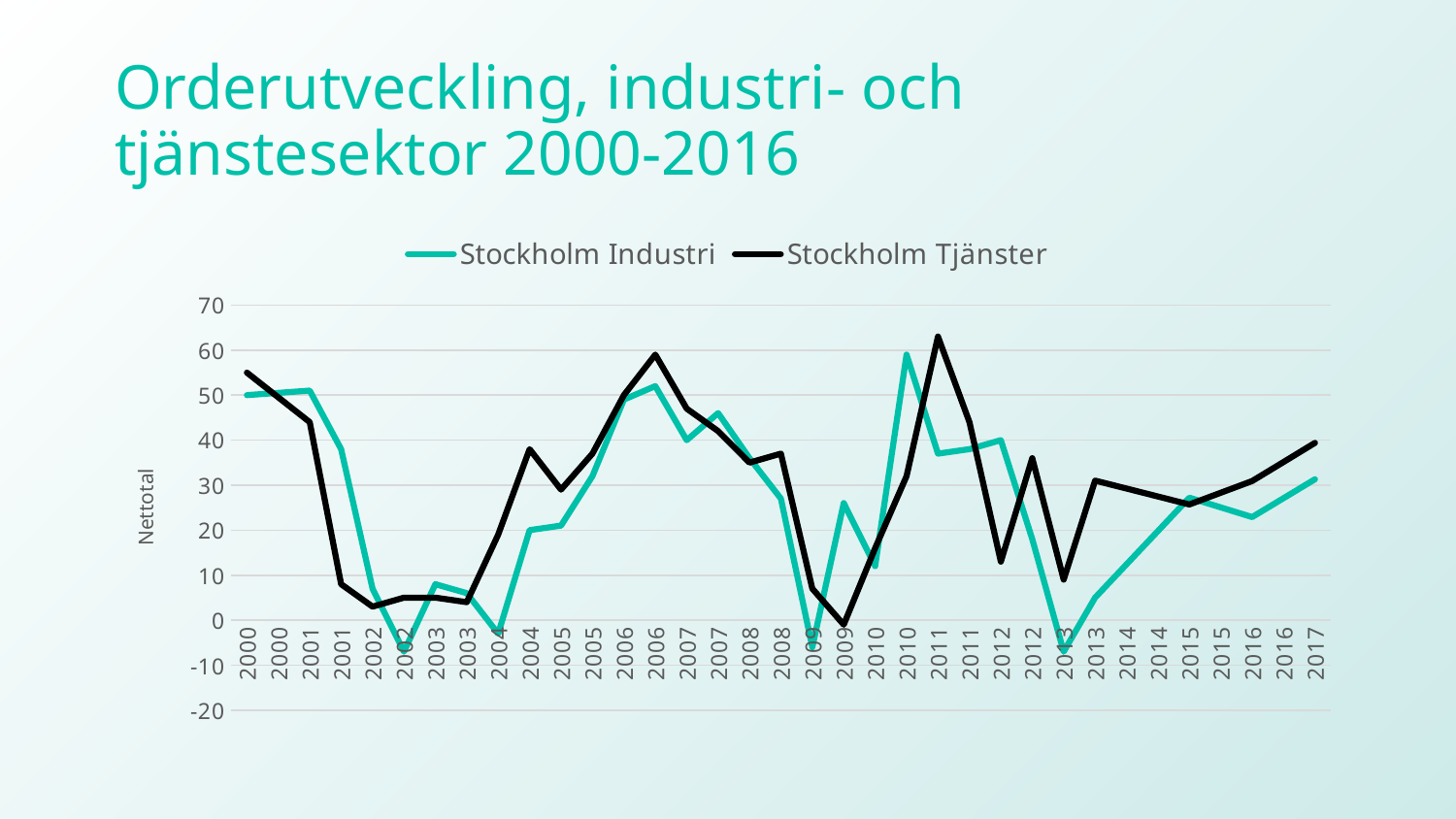
What is the label on the vertical axis? Nettotal In which year does Stockholm Tjänster reach its highest value? 2011 At the second 2010 point, which series has the higher value, Stockholm Industri or Stockholm Tjänster? Stockholm Industri Does the Stockholm Industri line rise or fall from 2000 to 2002? Fall Is the value for Stockholm Tjänster at 2017 greater or less than 30? greater At the first 2011 point, which series has the higher value, Stockholm Industri or Stockholm Tjänster? Stockholm Tjänster Is the value for Stockholm Industri at the second 2013 point greater or less than 0? greater How many series does the legend list? 2 What are the two series named in the legend? Stockholm Industri and Stockholm Tjänster Is the value for Stockholm Tjänster at the first 2011 point greater or less than 60? greater What kind of chart is shown on the slide? Line chart